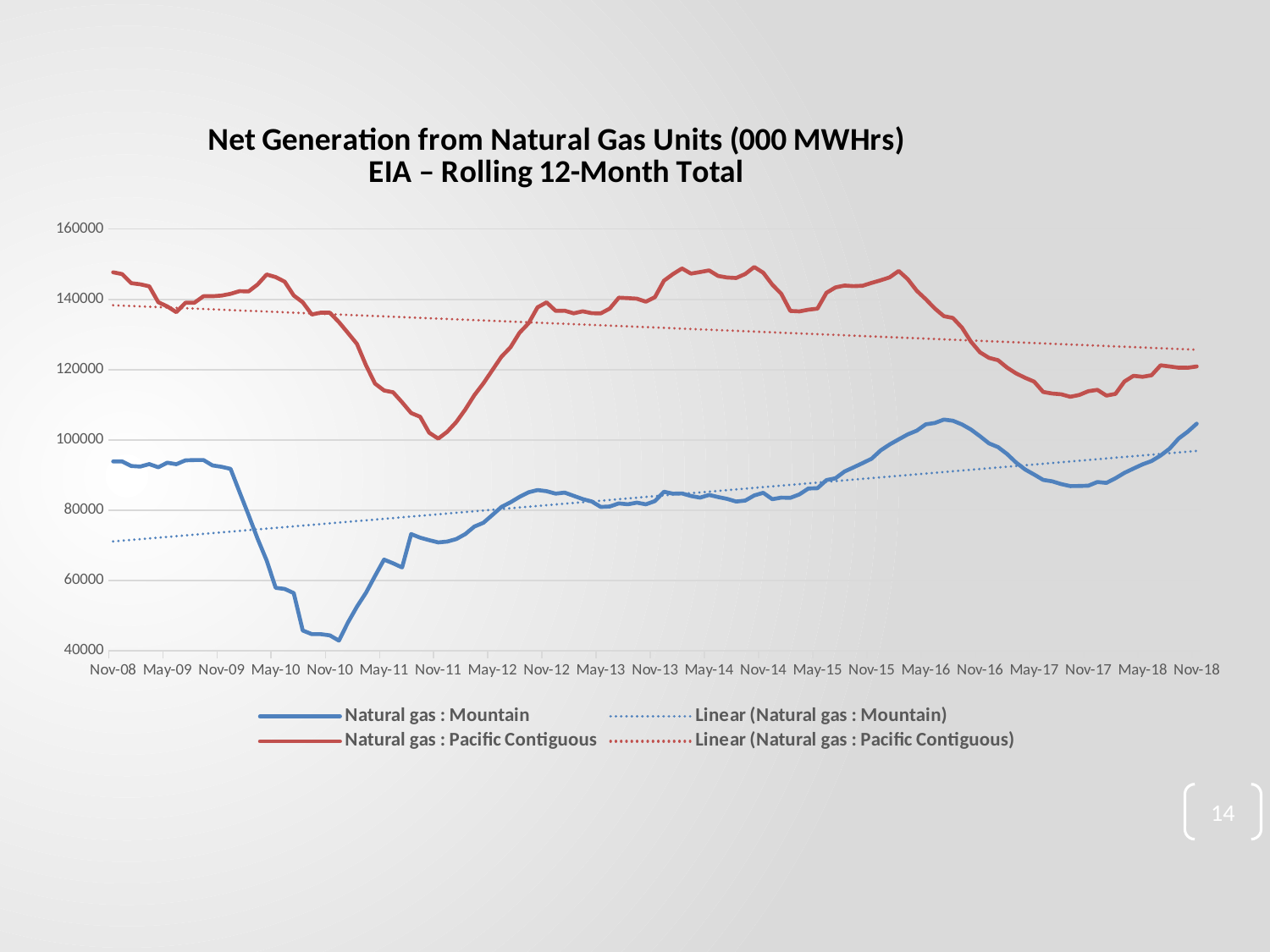
How many entries does the legend list? 4 Is the value for Natural gas : Mountain at Nov-10 greater or less than 60000? less Is the value for Natural gas : Pacific Contiguous at Nov-08 greater or less than 140000? greater Does the Linear (Natural gas : Mountain) trendline rise or fall from Nov-08 to Nov-18? rise Is the value for Natural gas : Pacific Contiguous at Nov-17 greater or less than 120000? less How many date labels are shown on the x axis? 21 Which colour is used for the Natural gas : Mountain series? blue Which series has the larger value at Nov-08, Natural gas : Mountain or Natural gas : Pacific Contiguous? Natural gas : Pacific Contiguous What kind of chart is shown on the slide? line chart Does the Linear (Natural gas : Pacific Contiguous) trendline rise or fall from Nov-08 to Nov-18? fall What is the title of the chart? Net Generation from Natural Gas Units (000 MWHrs) EIA – Rolling 12-Month Total